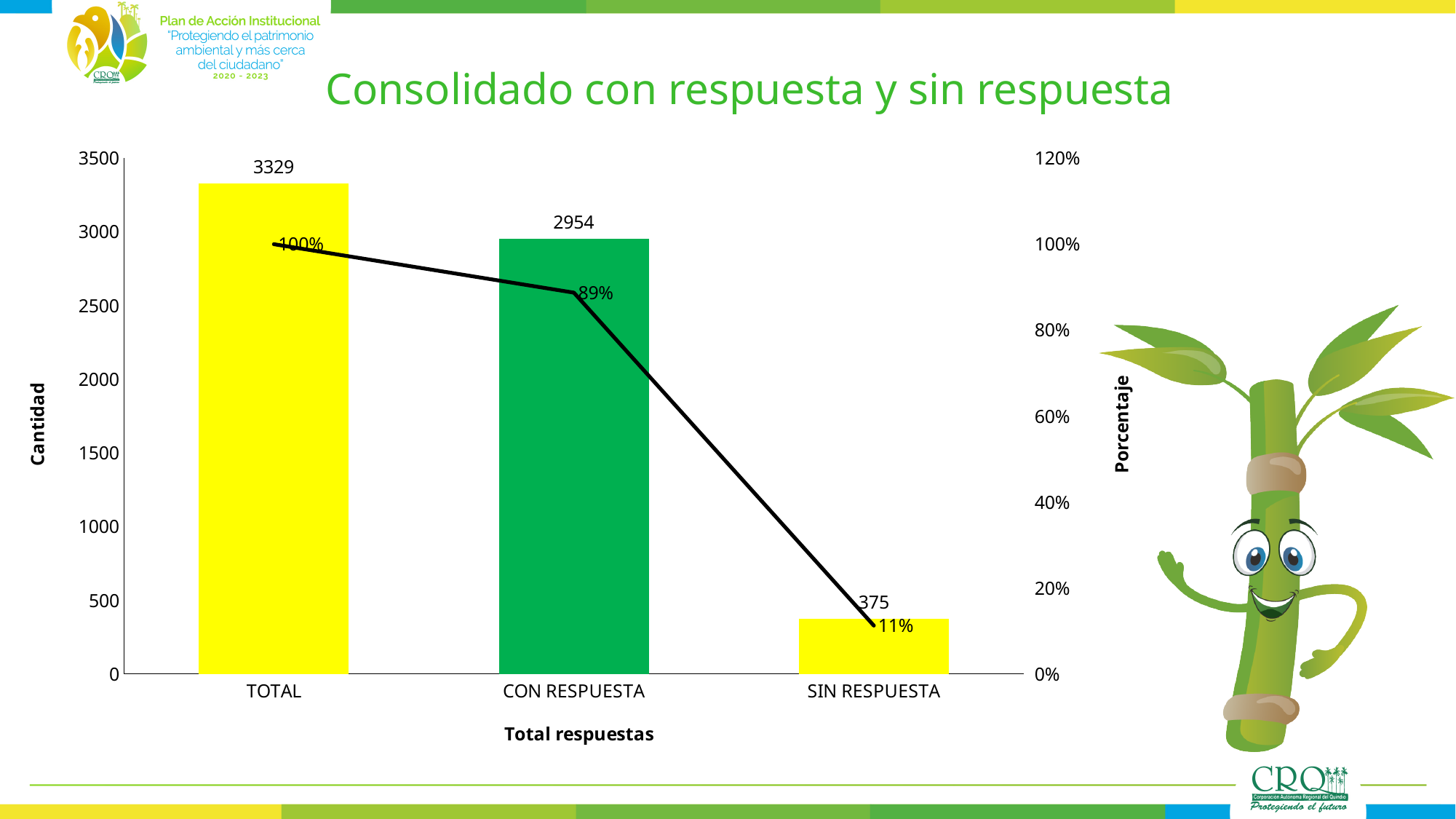
What is the Cantidad value for SIN RESPUESTA? 375 What percentage is shown for SIN RESPUESTA on the line? 11% What percentage is shown for CON RESPUESTA on the line? 89% How many categories are shown on the x axis? 3 Which category has the highest Cantidad value? TOTAL What is the Cantidad value for CON RESPUESTA? 2954 What is the title of the chart? Consolidado con respuesta y sin respuesta Which category has the lowest Cantidad value? SIN RESPUESTA What is the difference in Cantidad between CON RESPUESTA and SIN RESPUESTA? 2579 What is the Cantidad value for TOTAL? 3329 Which is larger, the Cantidad for CON RESPUESTA or for SIN RESPUESTA? CON RESPUESTA Do the percentage values on the line rise or fall from TOTAL to SIN RESPUESTA? fall